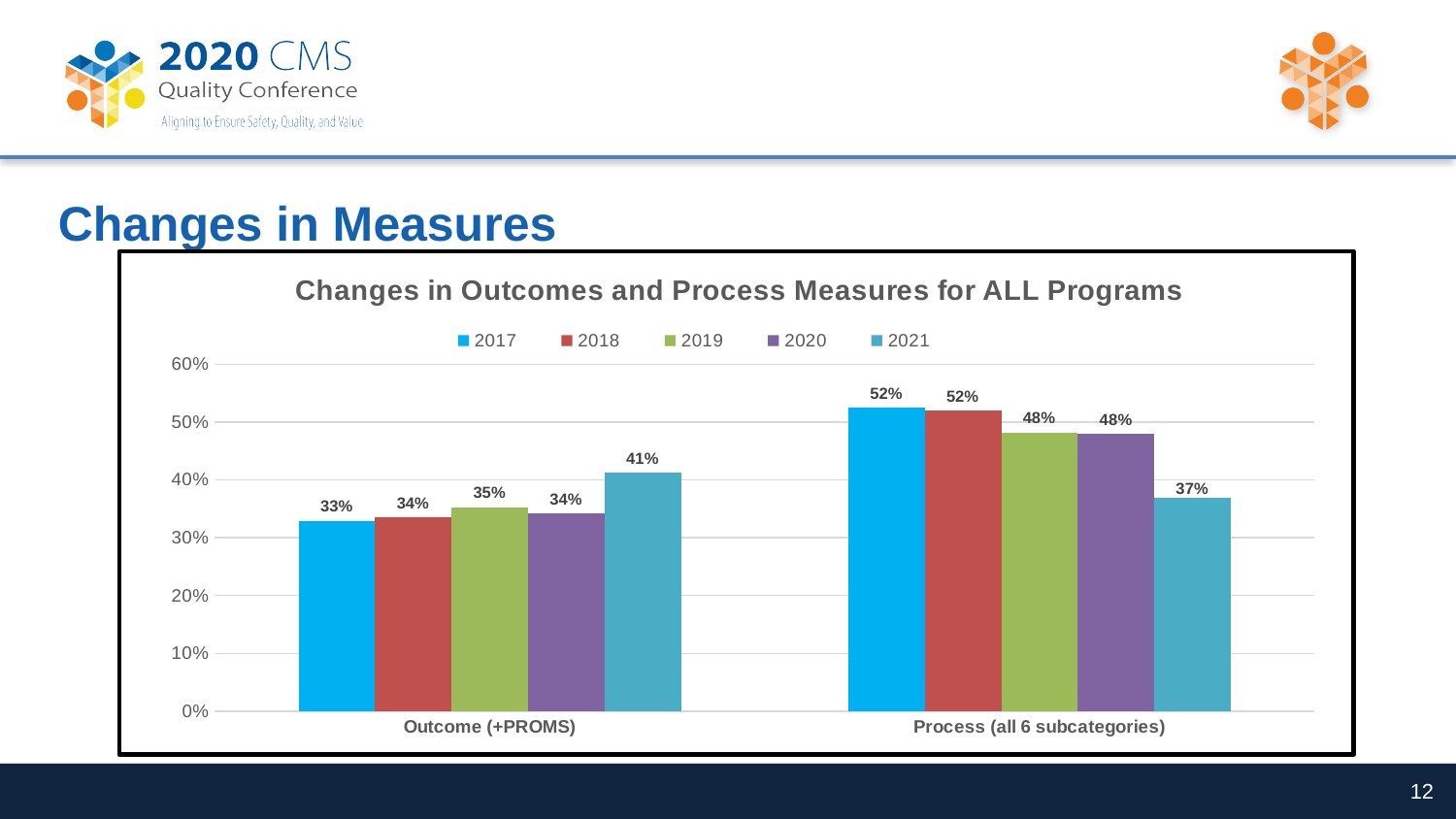
What is the difference between the 2021 and 2017 values in the Outcome (+PROMS) category? 8% How many categories are shown on the x axis? 2 Which year has the highest value in the Outcome (+PROMS) category? 2021 What is the title of the chart? Changes in Outcomes and Process Measures for ALL Programs What is the value for 2021 in the Outcome (+PROMS) category? 41% What is the difference between the 2017 and 2021 values in the Process (all 6 subcategories) category? 15% Which year has the lowest value in the Process (all 6 subcategories) category? 2021 What is the value for 2017 in the Process (all 6 subcategories) category? 52% What is the value for 2019 in the Outcome (+PROMS) category? 35% What kind of chart is shown on the slide? Bar chart How many series does the legend list? 5 Which is larger: the 2021 value for Outcome (+PROMS) or the 2021 value for Process (all 6 subcategories)? Outcome (+PROMS)